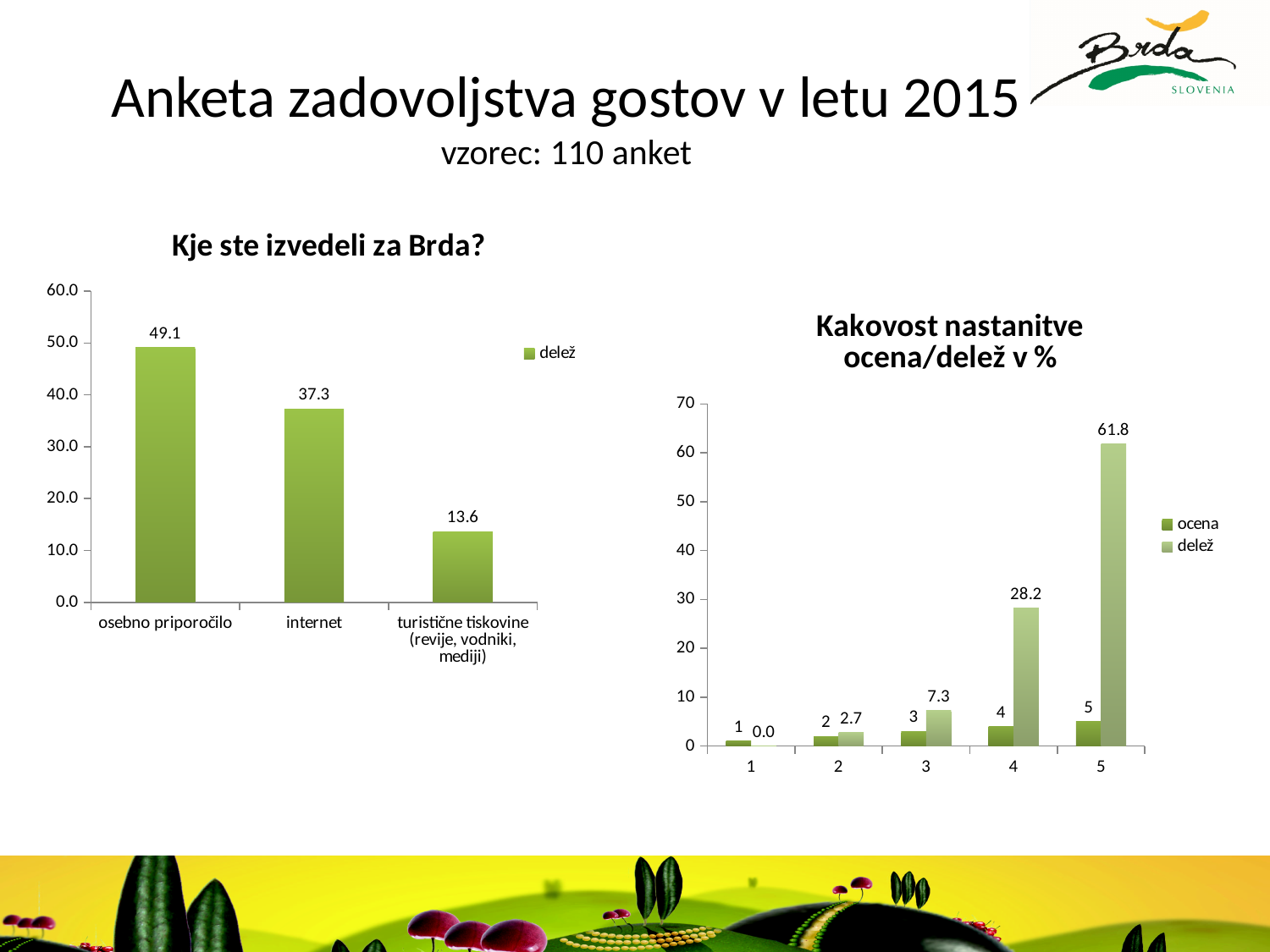
In the chart 'Kje ste izvedeli za Brda?', what is the value for 'internet'? 37.3 In the chart 'Kje ste izvedeli za Brda?', what is the difference between the values for 'osebno priporočilo' and 'internet'? 11.8 In the chart 'Kakovost nastanitve ocena/delež v %', which is larger: the 'delež' value for category 2 or for category 3? category 3 In the chart 'Kje ste izvedeli za Brda?', which category has the lowest value? turistične tiskovine (revije, vodniki, mediji) In the chart 'Kakovost nastanitve ocena/delež v %', do the 'delež' values rise or fall from category 1 to category 5? rise In the chart 'Kakovost nastanitve ocena/delež v %', what is the 'delež' value for category 5? 61.8 In the chart 'Kakovost nastanitve ocena/delež v %', what is the difference between the 'delež' values for categories 5 and 4? 33.6 In the chart 'Kje ste izvedeli za Brda?', how many categories are shown? 3 In the chart 'Kje ste izvedeli za Brda?', which category has the highest value? osebno priporočilo In the chart 'Kakovost nastanitve ocena/delež v %', how many series does the legend list? 2 In the chart 'Kakovost nastanitve ocena/delež v %', what is the 'delež' value for category 3? 7.3 What kind of chart is 'Kje ste izvedeli za Brda?'? bar chart